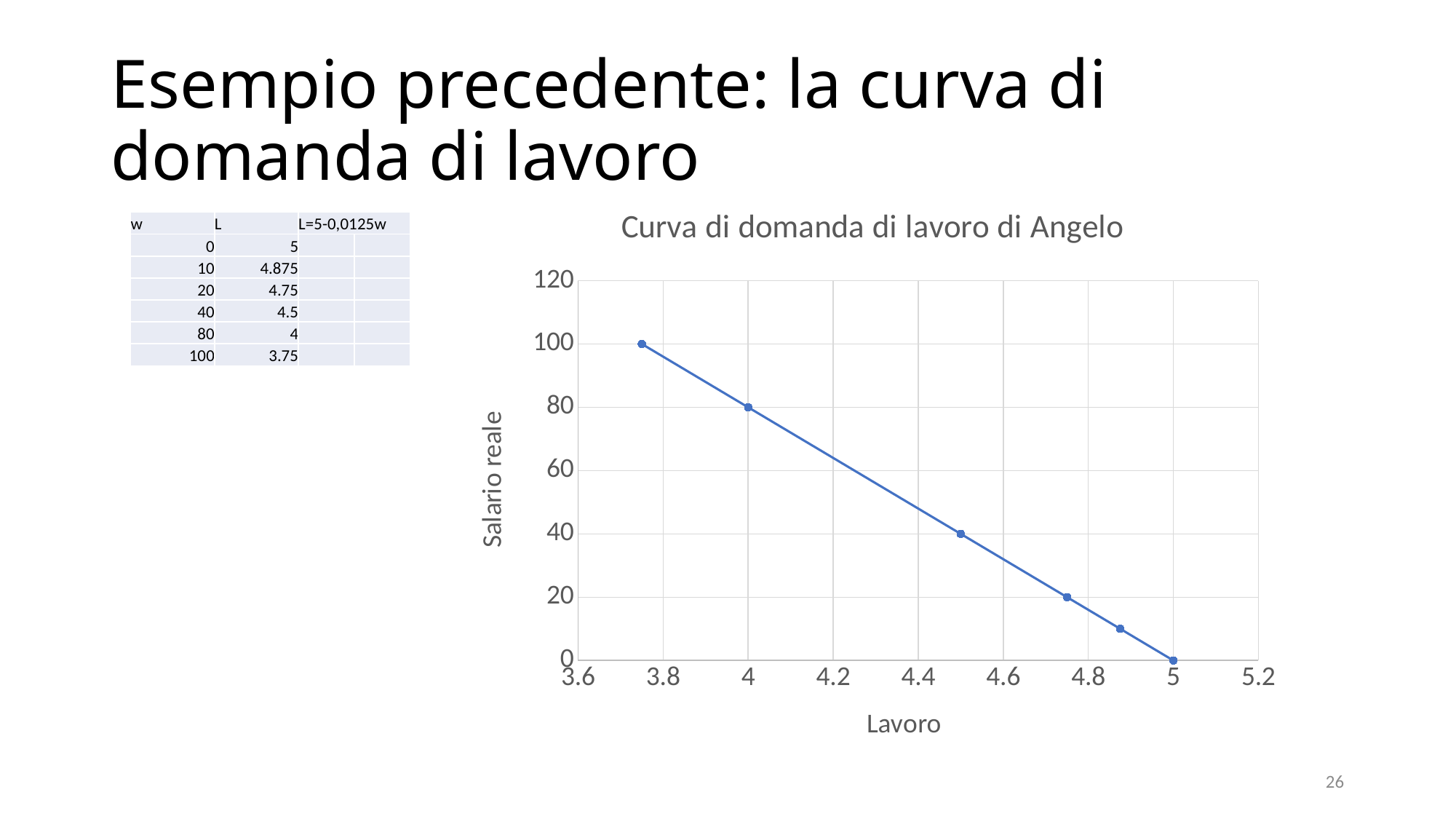
How many data points are plotted on the chart? 6 What is the difference in Salario reale between Lavoro = 4 and Lavoro = 4.5? 40 Which has a larger Salario reale: Lavoro = 4.75 or Lavoro = 4? Lavoro = 4 What is the title of the chart? Curva di domanda di lavoro di Angelo What is the value of Salario reale when Lavoro is 4.5? 40 What is the value of Salario reale when Lavoro is 3.75? 100 What is the label of the x axis? Lavoro What kind of chart is shown on the slide? line chart What is the highest value of Salario reale plotted on the chart? 100 Does Salario reale rise or fall as Lavoro increases along the x axis? fall What is the value of Salario reale when Lavoro is 5? 0 What is the value of Salario reale when Lavoro is 4? 80